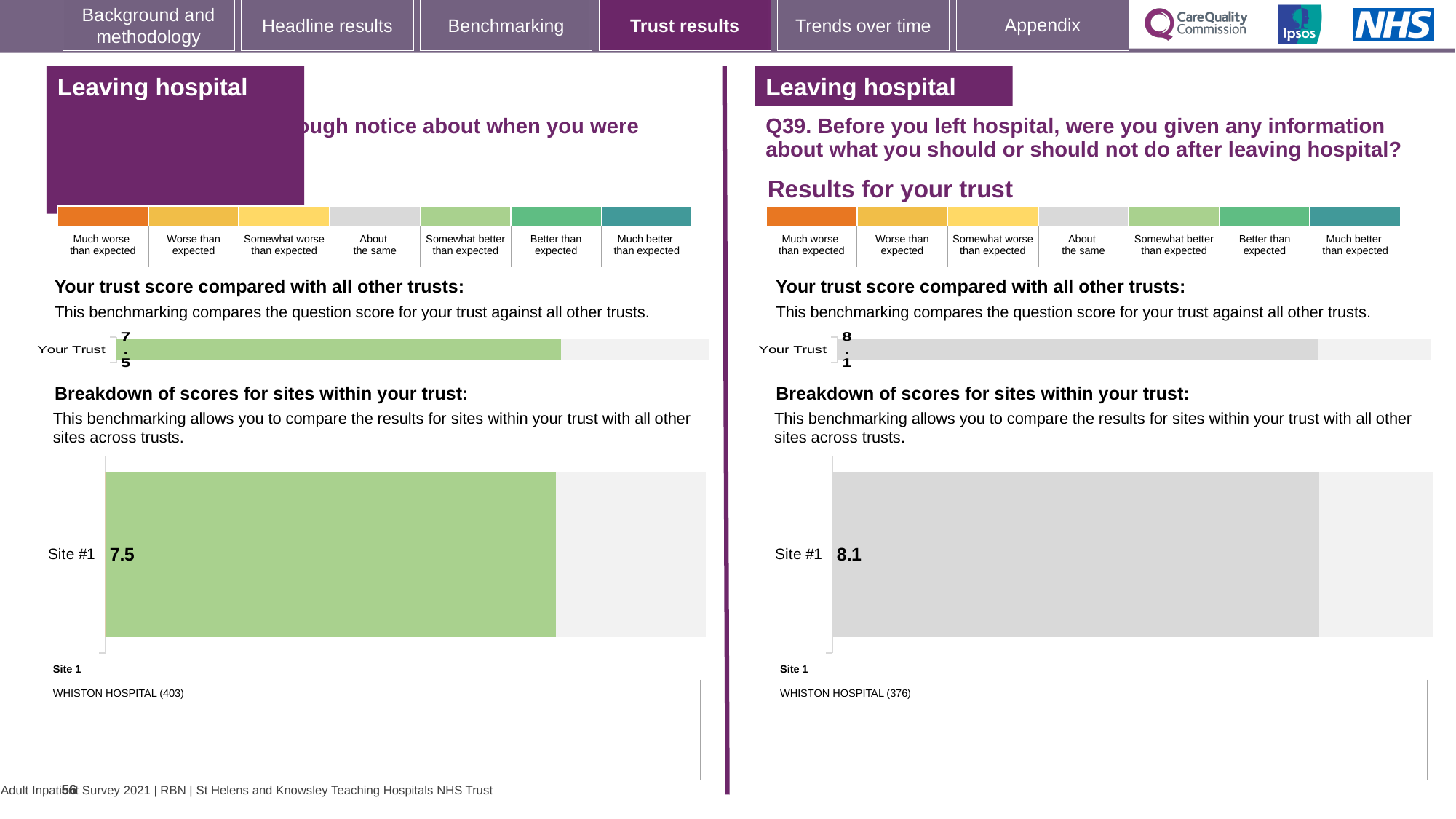
On the left-hand 'Breakdown of scores for sites within your trust' chart, what is the value for Site #1? 7.5 What is the difference between the Site #1 score on the right-hand Q39 chart and the Site #1 score on the left-hand chart? 0.6 Which benchmark category does the colour of the Your Trust bar on the left-hand chart correspond to? Somewhat better than expected Which benchmark category does the colour of the Your Trust bar on the right-hand Q39 chart correspond to? About the same How many sites are shown in the right-hand 'Breakdown of scores for sites within your trust' chart for Q39? 1 How many sites are shown in the left-hand 'Breakdown of scores for sites within your trust' chart? 1 Which is larger: the Your Trust score on the left-hand chart or the Your Trust score on the right-hand Q39 chart? The right-hand Q39 chart Which site is listed as Site 1 below the right-hand Q39 breakdown chart? WHISTON HOSPITAL (376) On the right-hand 'Breakdown of scores for sites within your trust' chart for Q39, what is the value for Site #1? 8.1 On the left-hand 'Your trust score compared with all other trusts' chart, what is the value for Your Trust? 7.5 On the right-hand 'Your trust score compared with all other trusts' chart for Q39, what is the value for Your Trust? 8.1 What kind of chart is used to show the Site #1 score on the left-hand side of the slide? Bar chart